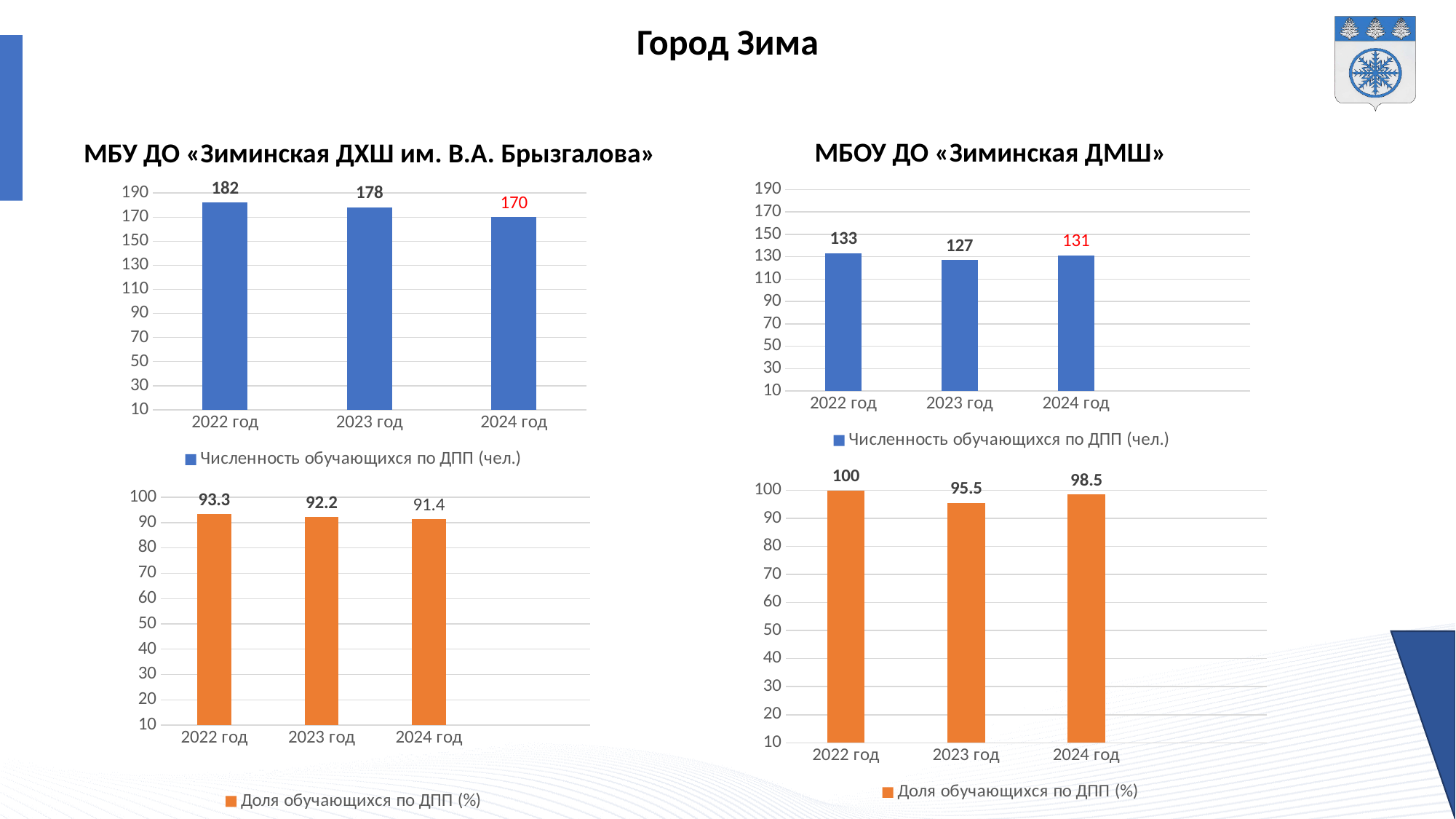
In the top-left chart (Численность обучающихся по ДПП for МБУ ДО «Зиминская ДХШ им. В.А. Брызгалова»), what is the value for 2022 год? 182 In the top-right chart (Численность обучающихся по ДПП for МБОУ ДО «Зиминская ДМШ»), what is the value for 2023 год? 127 In the top-left chart (Численность обучающихся по ДПП for ДХШ), what is the value for 2024 год? 170 In the top-right chart (Численность обучающихся по ДПП for ДМШ), what is the difference between 2022 год and 2023 год? 6 In the top-left chart (Численность обучающихся по ДПП for ДХШ), by how much did the value fall from 2022 год to 2024 год? 12 In the top-left chart (Численность обучающихся по ДПП for ДХШ), do the values rise or fall from 2022 год to 2024 год? fall How many charts are shown on the slide, and what type are they? 4 bar charts In the bottom-right chart (Доля обучающихся по ДПП for ДМШ), which is larger: the value for 2023 год or 2024 год? 2024 год In the top-right chart (Численность обучающихся по ДПП for ДМШ), which year has the highest value? 2022 год In the bottom-left chart (Доля обучающихся по ДПП for ДХШ), what is the value for 2023 год? 92.2 In the bottom-left chart (Доля обучающихся по ДПП for ДХШ), which year has the lowest value? 2024 год In the bottom-right chart (Доля обучающихся по ДПП for ДМШ), what is the value for 2024 год? 98.5